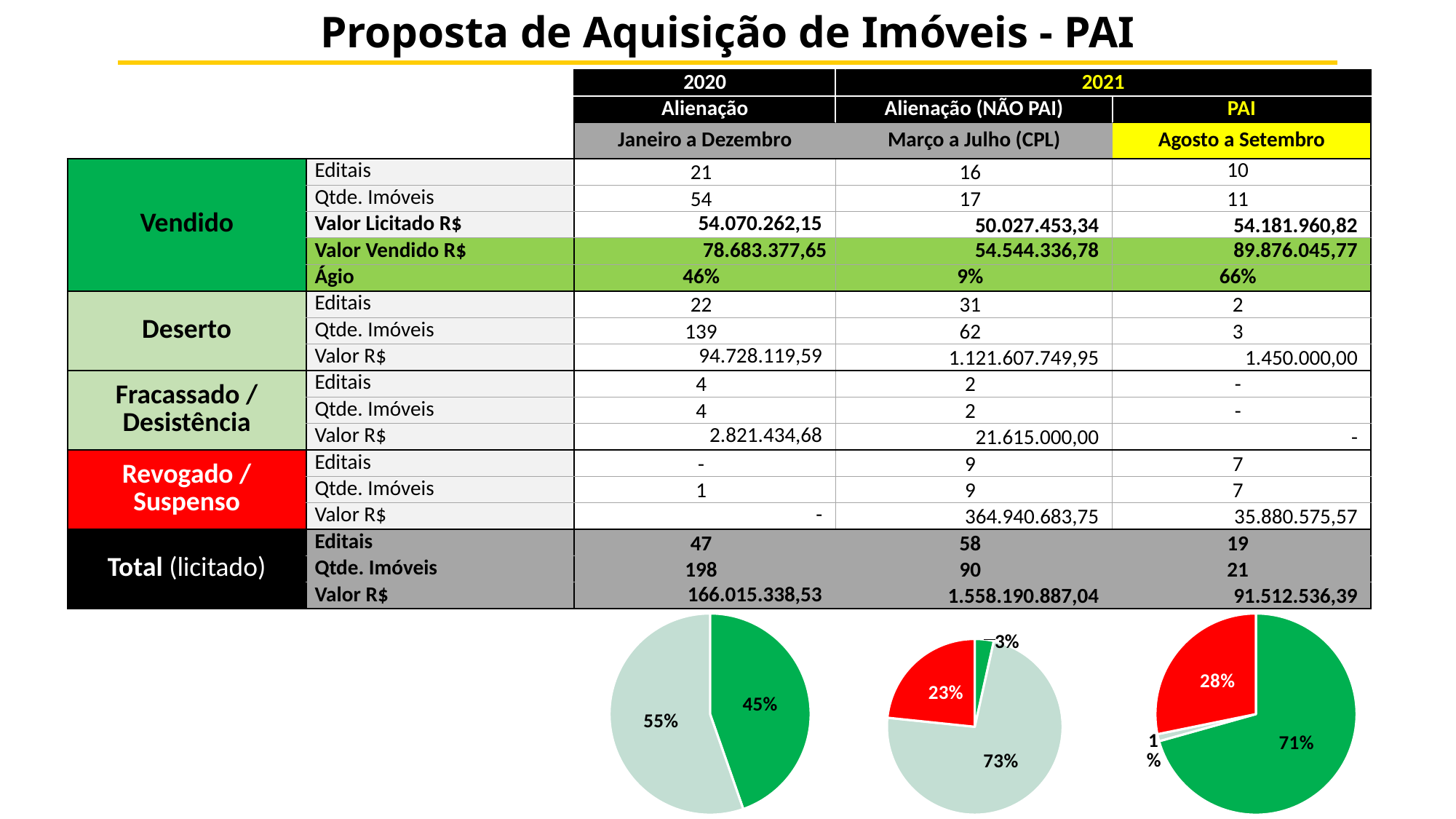
In the right-hand pie chart, what share is shown for the dark green slice? 71% How many slices does the middle pie chart at the bottom of the slide have? 3 How many slices does the left-hand pie chart at the bottom of the slide have? 2 In the right-hand pie chart, what share is shown for the red slice? 28% In the right-hand pie chart, what is the difference in percentage points between the dark green slice and the red slice? 43 In the middle pie chart, what is the smallest slice's share? 3% In the left-hand pie chart, what share is shown for the light green slice? 55% In the middle pie chart, what is the largest slice's share? 73% In the middle pie chart, which slice is larger, the red slice or the dark green slice? the red slice What kind of chart is the left-hand chart at the bottom of the slide? pie chart